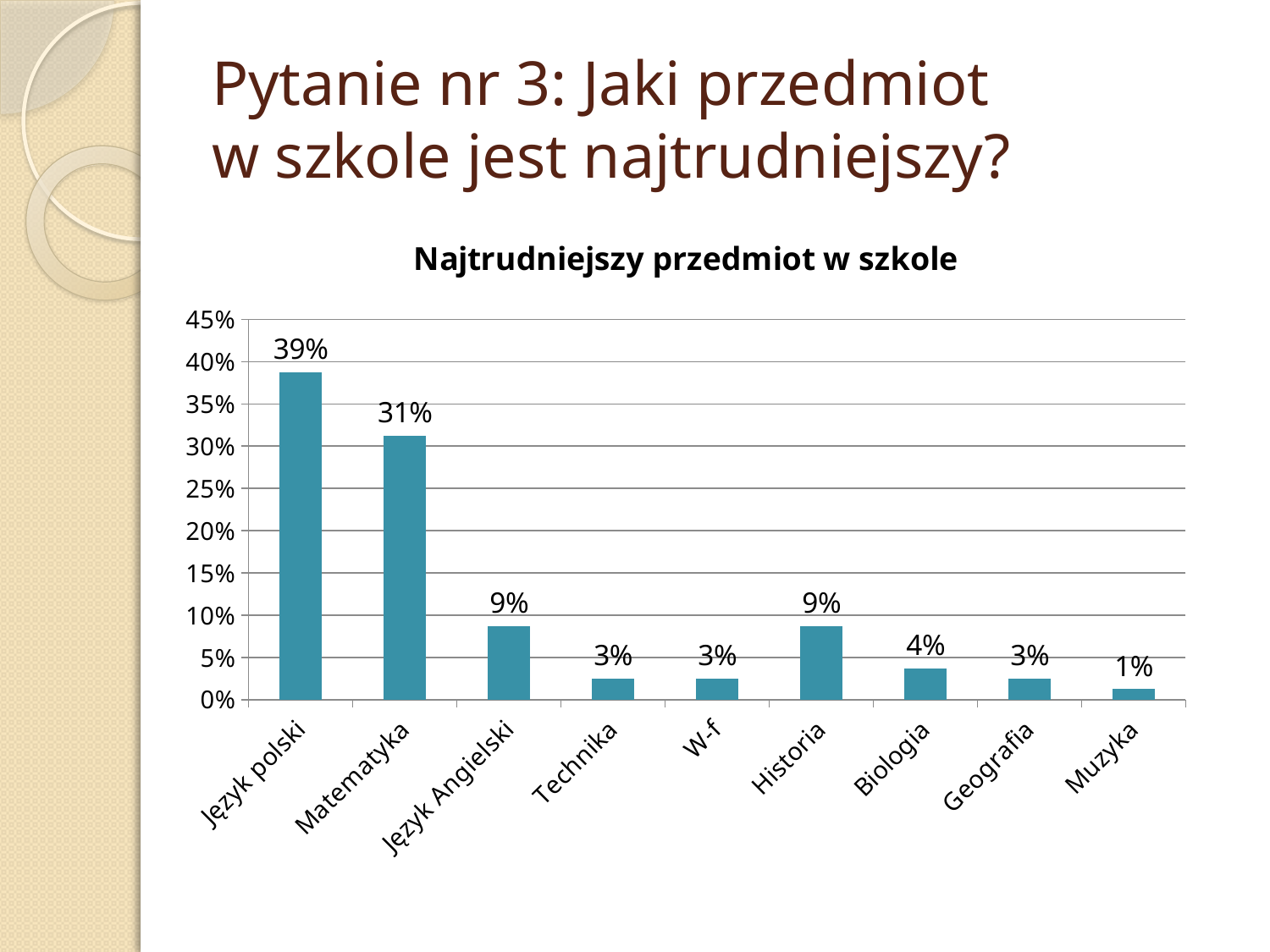
What is the value for Język polski? 39% What kind of chart is shown on the slide? bar chart What is the value for Biologia? 4% What is the value for Matematyka? 31% What is the difference between the values for Język polski and Matematyka? 8% Which subject has the highest value? Język polski How many subjects are shown on the x axis? 9 Is the value for Matematyka greater or less than 30%? greater What is the title of the chart? Najtrudniejszy przedmiot w szkole Which subject has the lowest value? Muzyka What is the value for Muzyka? 1% Which is larger, the value for Historia or the value for Biologia? Historia